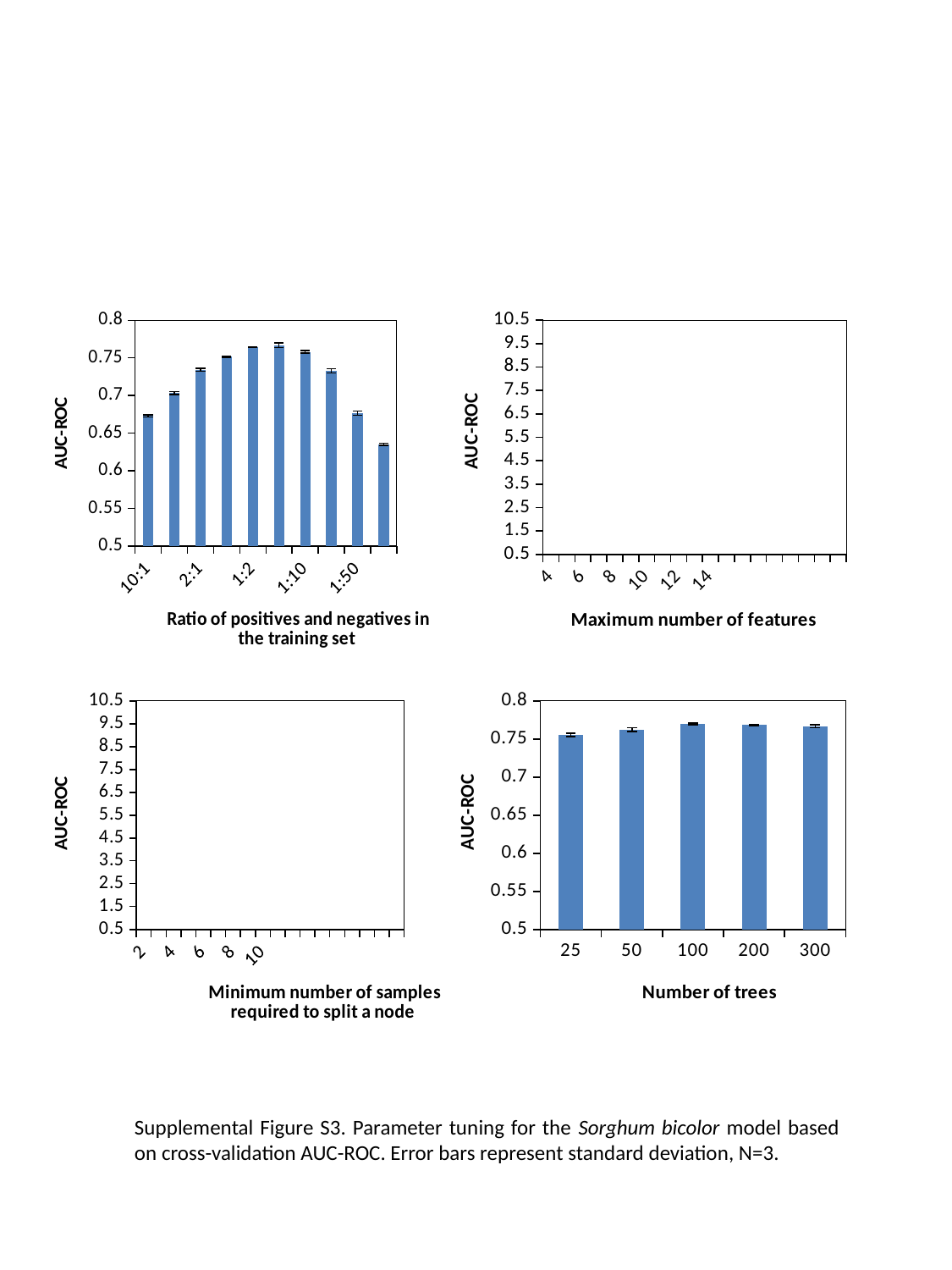
In the 'Ratio of positives and negatives in the training set' chart, which has the larger value, 10:1 or 2:1? 2:1 In the 'Number of trees' chart, which has the larger value, 25 or 100? 100 In the 'Ratio of positives and negatives in the training set' chart, is the value for 1:2 greater or less than 0.75? greater In the 'Ratio of positives and negatives in the training set' chart, which has the larger value, 1:2 or 1:50? 1:2 How many bars are plotted in the 'Number of trees' chart? 5 In the 'Ratio of positives and negatives in the training set' chart, is the value for 1:50 greater or less than 0.7? less What is the y-axis label of the 'Number of trees' chart? AUC-ROC How many charts are shown on the slide? 4 What kind of chart is the 'Ratio of positives and negatives in the training set' chart? bar chart How many bars are plotted in the 'Ratio of positives and negatives in the training set' chart? 10 In the 'Ratio of positives and negatives in the training set' chart, is the value for 10:1 greater or less than 0.65? greater